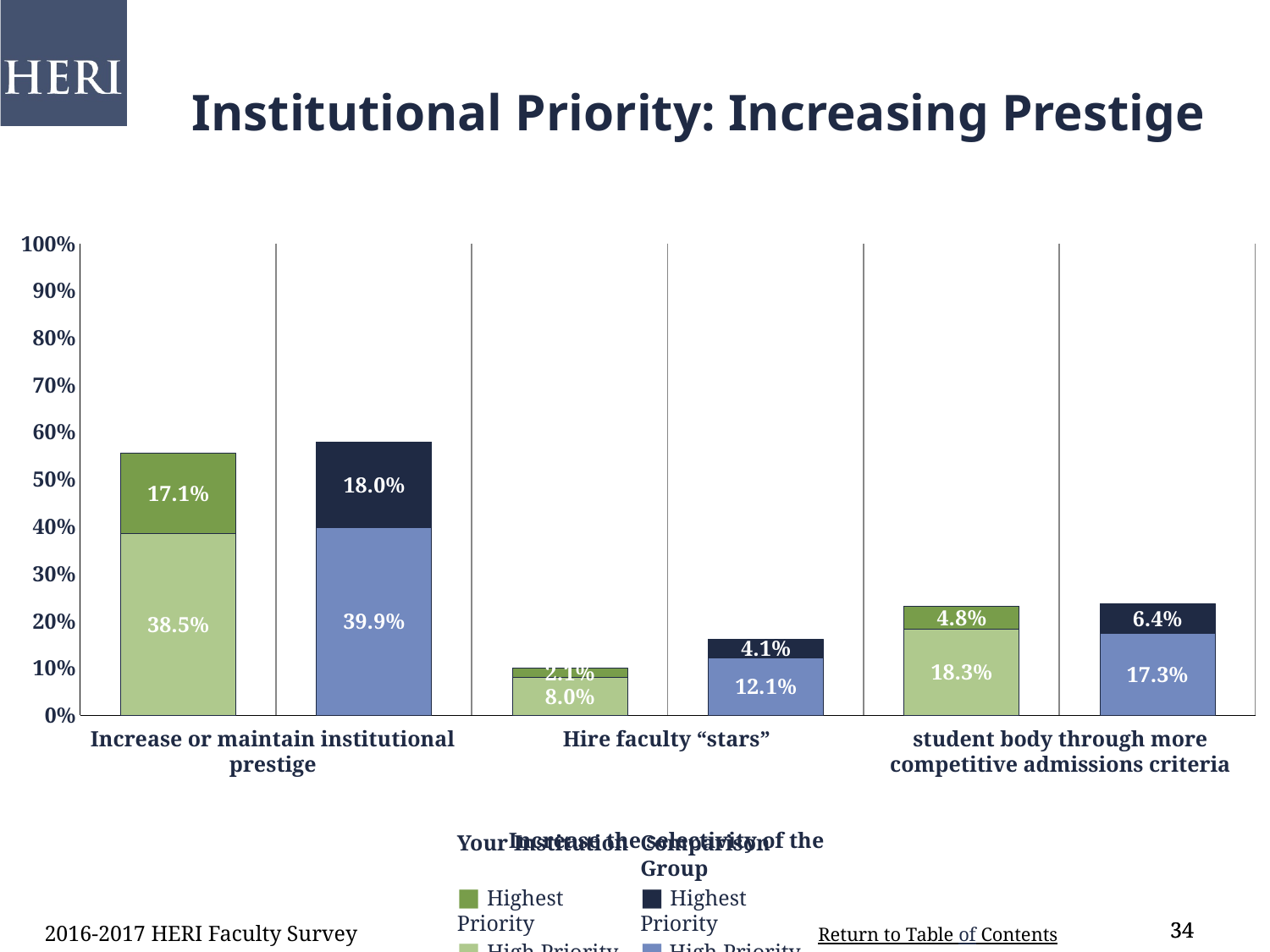
What percentage of the Comparison Group rated "Increase or maintain institutional prestige" as the Highest Priority? 18.0% Which is larger: the Highest Priority value for Your Institution or for the Comparison Group on the student body selectivity category? Comparison Group What is the Highest Priority value for Your Institution on "Hire faculty "stars""? 2.1% What type of chart is shown on the slide? Stacked bar chart How many categories are shown on the x axis? 3 Which category has the lowest total stacked bar for Your Institution? Hire faculty "stars" What is the High Priority value for the Comparison Group on "Hire faculty "stars""? 12.1% Which category has the highest total stacked bar for the Comparison Group? Increase or maintain institutional prestige What is the total of the stacked bar for Your Institution on "Increase or maintain institutional prestige"? 55.6% What percentage of faculty at Your Institution rated "Increase or maintain institutional prestige" as a High Priority? 38.5% What is the total of the stacked bar for the Comparison Group on "Hire faculty "stars""? 16.2% What is the difference between the Comparison Group's and Your Institution's High Priority values for "Increase or maintain institutional prestige"? 1.4%